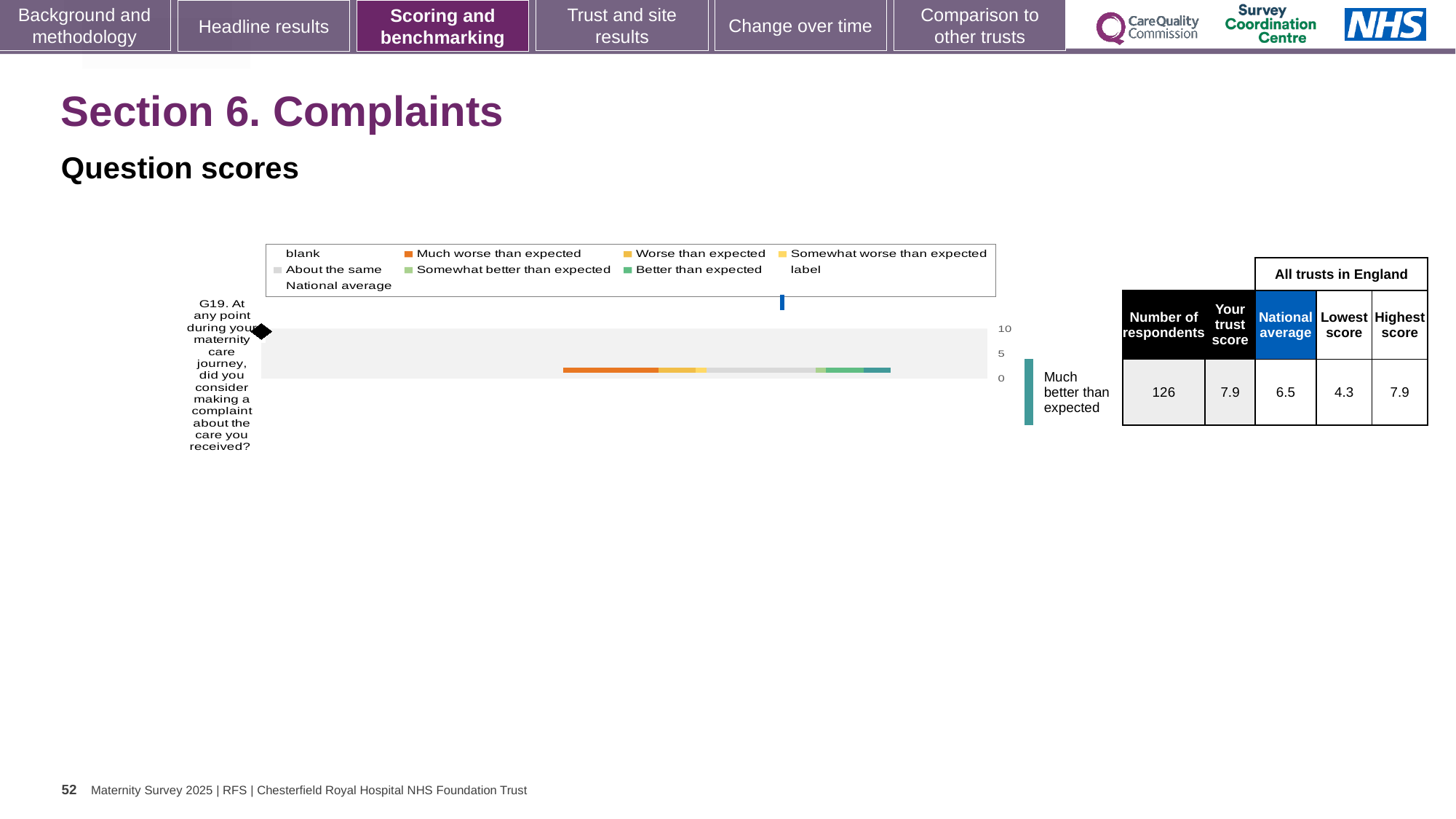
What is the trust score for question G19 about considering making a complaint? 7.9 What is the difference between the trust score and the national average for question G19? 1.4 What is the lowest score among all trusts in England for question G19? 4.3 What kind of chart is used to show the question score? Bar chart What is the national average score for question G19? 6.5 What is the highest score among all trusts in England for question G19? 7.9 What is the difference between the highest and lowest scores across all trusts in England for question G19? 3.6 Is the trust score for question G19 greater or less than 5? greater How many survey questions are plotted on the chart? 1 What benchmark category is shown for question G19? Much better than expected Which is larger for question G19, the trust score or the national average? Your trust score How many respondents answered question G19? 126